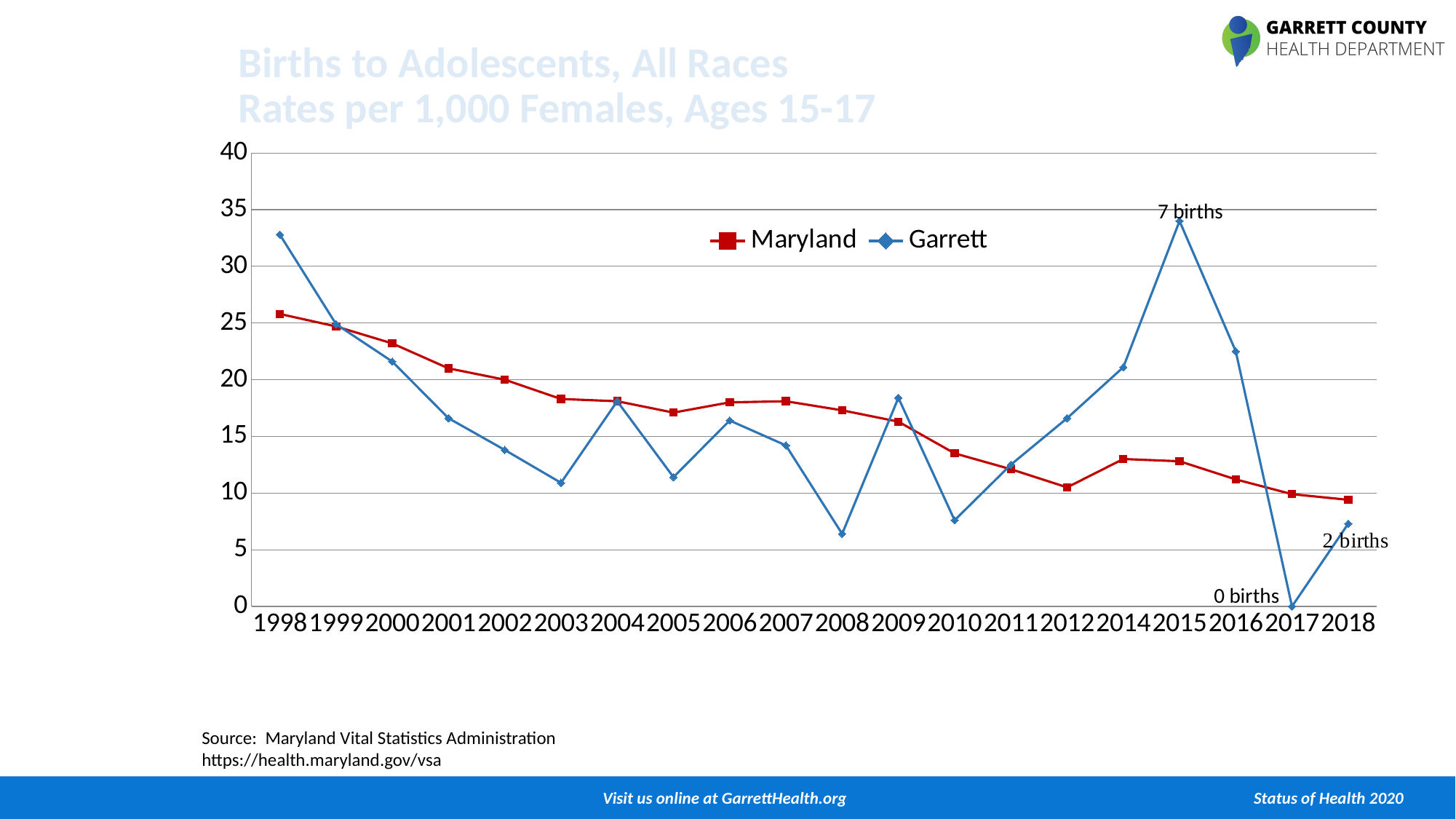
Is the Garrett value for 1998 greater or less than 30? greater What kind of chart is shown on the slide? Line chart Is the Garrett value for 2008 greater or less than 10? less In which year does the Garrett series reach its lowest value? 2017 In which year does the Garrett series reach its highest value? 2015 Does the Maryland series generally rise or fall from 1998 to 2018? Fall What is the Garrett rate in 2017? 0 In 2015, which series has the higher value, Maryland or Garrett? Garrett In which year is the Maryland rate highest? 1998 How many years are plotted along the x axis? 20 How many series does the legend list? 2 Is the Maryland value for 2012 greater or less than 15? less